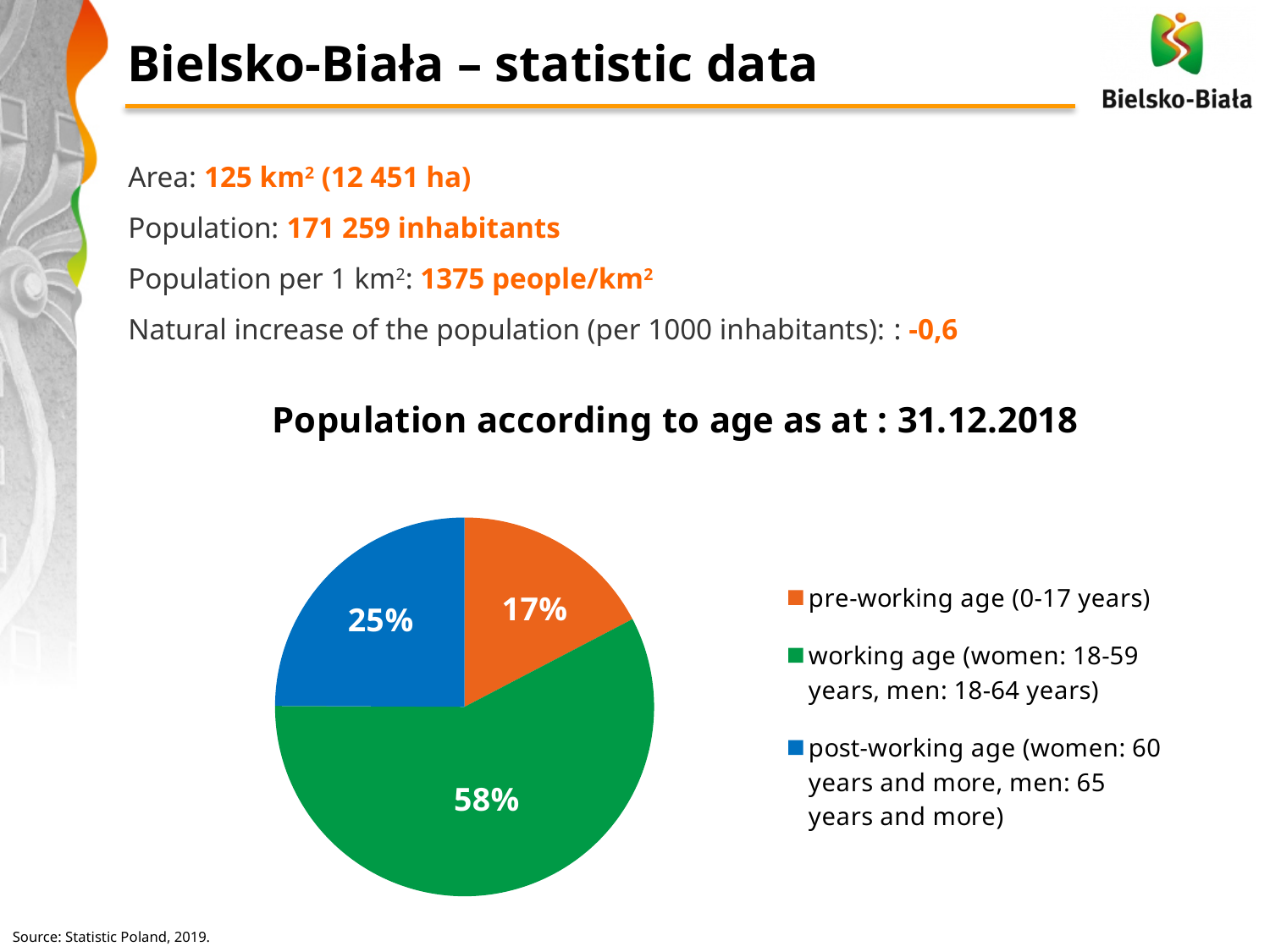
Which age group has the smallest share of the population? pre-working age (0-17 years) What is the difference in percentage points between the working age share and the post-working age share? 33 What share of the population is of pre-working age (0-17 years)? 17% What share of the population is of working age? 58% What share of the population is of post-working age? 25% Which is larger, the share of post-working age or the share of pre-working age? post-working age What is the difference in percentage points between the post-working age share and the pre-working age share? 8 What kind of chart is shown on the slide? pie chart What is the title of the pie chart? Population according to age as at : 31.12.2018 How many age groups does the pie chart show? 3 Which age group has the largest share of the population? working age What colour is the slice for working age? green